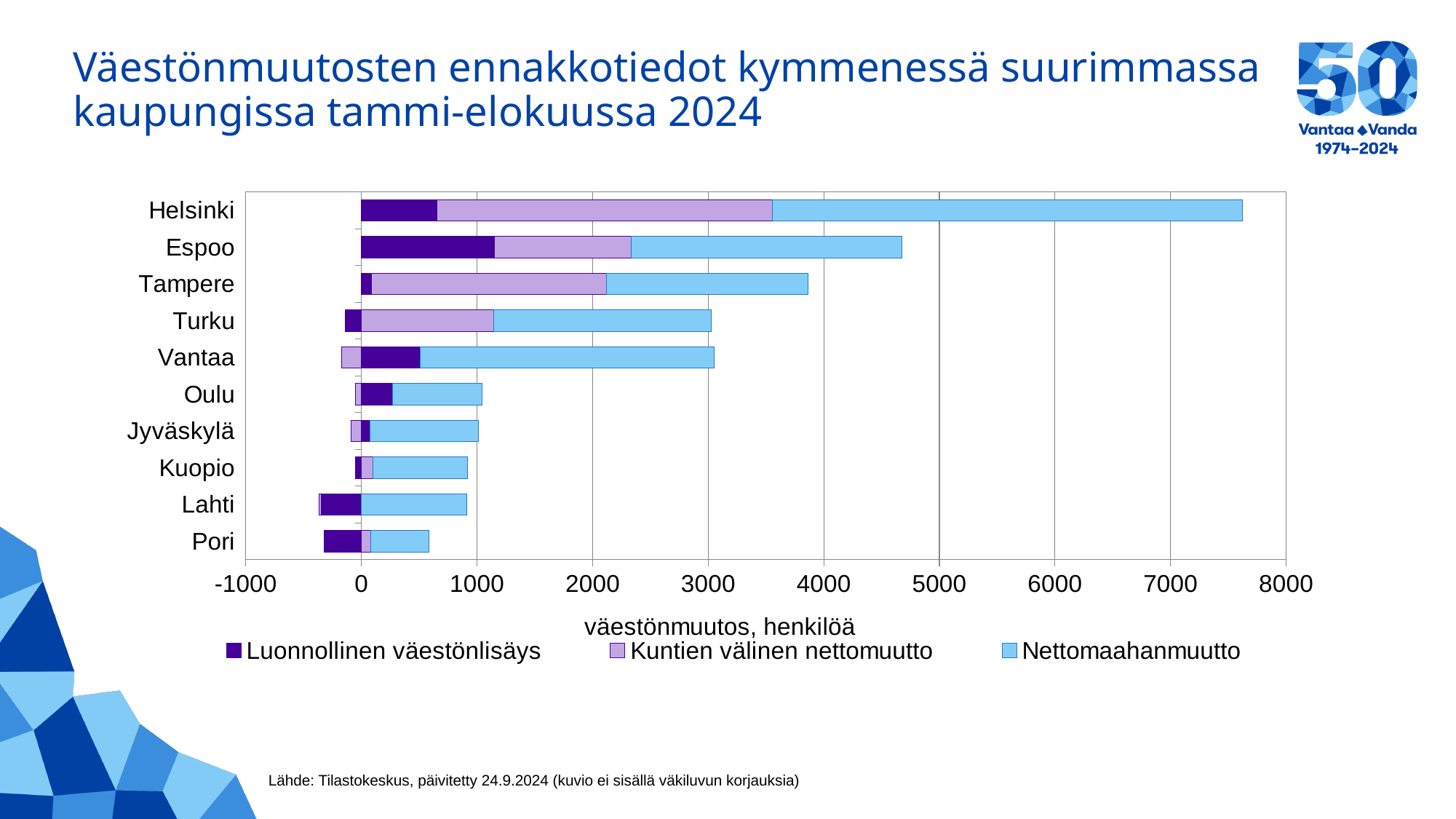
Is the Luonnollinen väestönlisäys value for Espoo greater or less than 1000? greater Is the total bar for Helsinki greater or less than 7000? greater Which city has the larger total bar, Espoo or Tampere? Espoo Is the total bar for Espoo greater or less than 4000? greater How many cities are shown on the chart? 10 Which legend entry is shown in light blue? Nettomaahanmuutto What kind of chart is shown on the slide? Stacked bar chart Which city has the shortest positive total bar on the chart? Pori How many series does the legend list? 3 Which city has the longest total bar on the chart? Helsinki What is the label of the horizontal axis? väestönmuutos, henkilöä